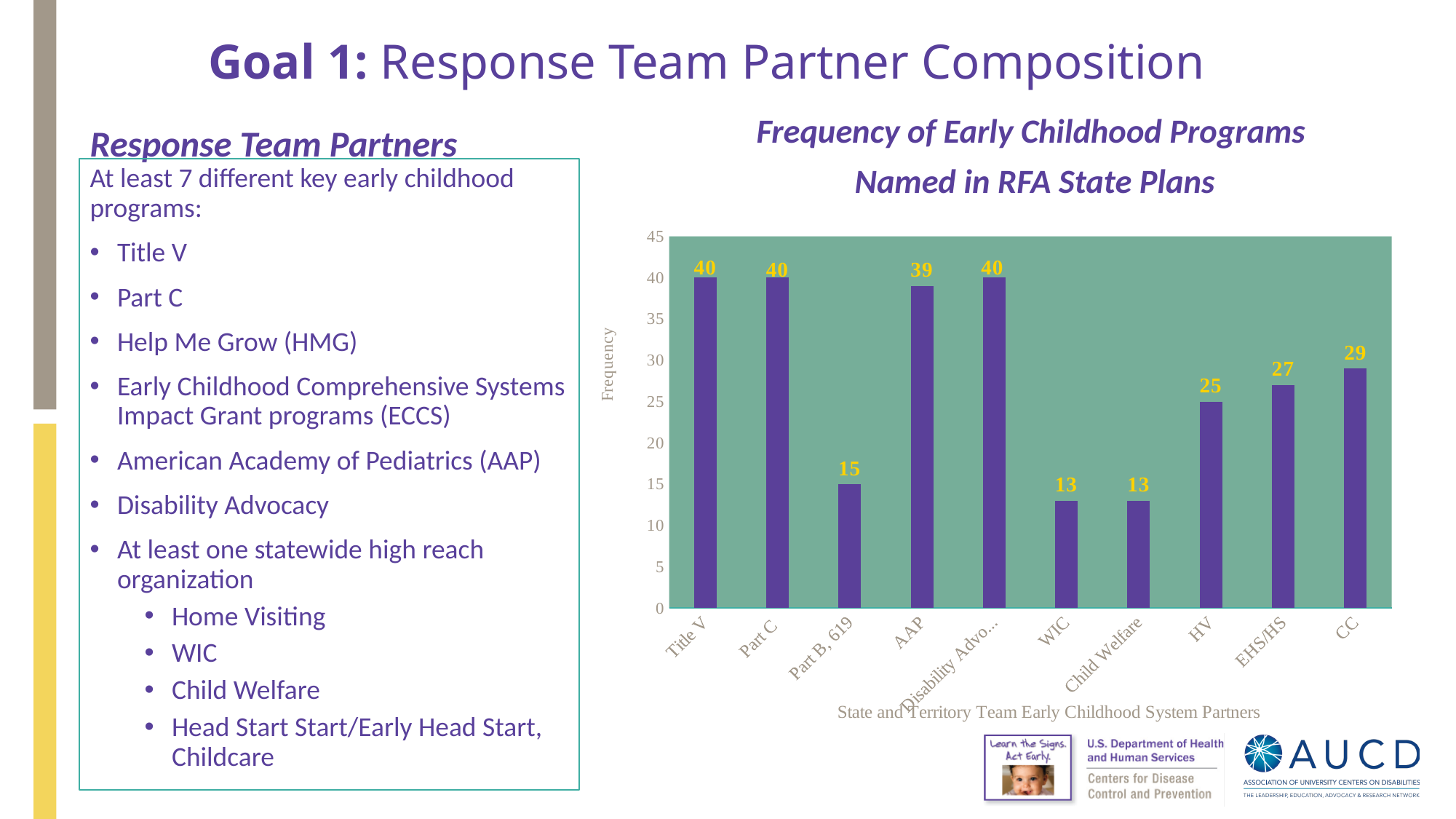
What is the difference between the frequency for CC and the frequency for EHS/HS? 2 What is the frequency for AAP? 39 Which has a higher frequency, AAP or Part C? Part C How many categories are shown on the x axis of the chart? 10 What is the frequency for CC? 29 What is the difference between the frequency for Title V and the frequency for Part B, 619? 25 What is the frequency for Part B, 619? 15 What is the label of the y axis of the chart? Frequency Which has a higher frequency, HV or EHS/HS? EHS/HS What is the frequency for HV? 25 What is the frequency for WIC? 13 What kind of chart is shown on the slide? Bar chart